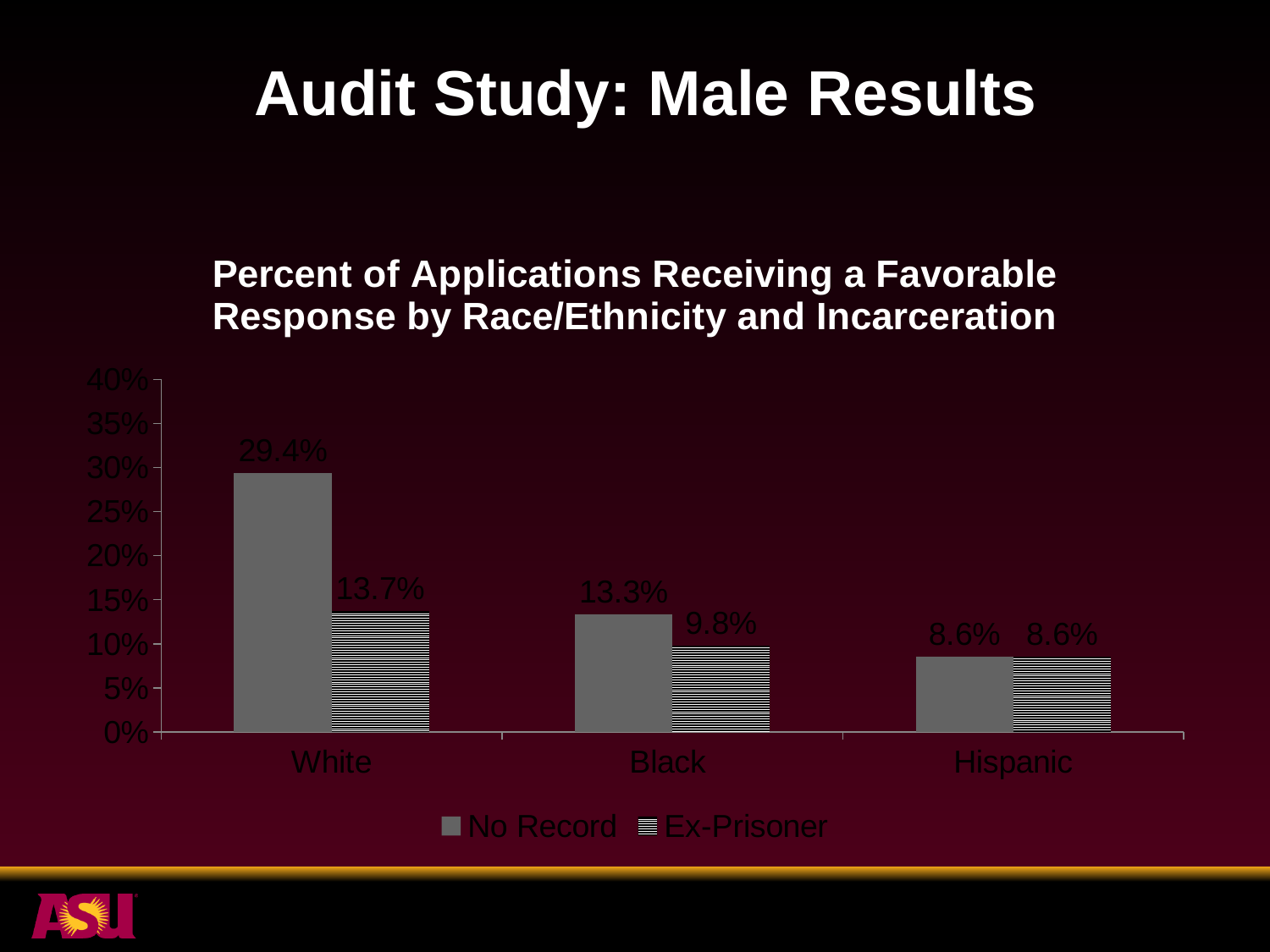
Which category has the highest No Record value? White Which is larger, the Ex-Prisoner value for White or the No Record value for Black? Ex-Prisoner value for White What is the No Record value for White? 29.4% What is the Ex-Prisoner value for Hispanic? 8.6% Which category has the lowest Ex-Prisoner value? Hispanic Is the No Record value for White greater or less than 25%? greater What is the difference between the No Record values for White and Black? 16.1% What is the difference between the No Record and Ex-Prisoner values for White? 15.7% What is the Ex-Prisoner value for Black? 9.8% How many categories are shown on the x axis? 3 What kind of chart is shown on the slide? Bar chart How many series does the legend list? 2